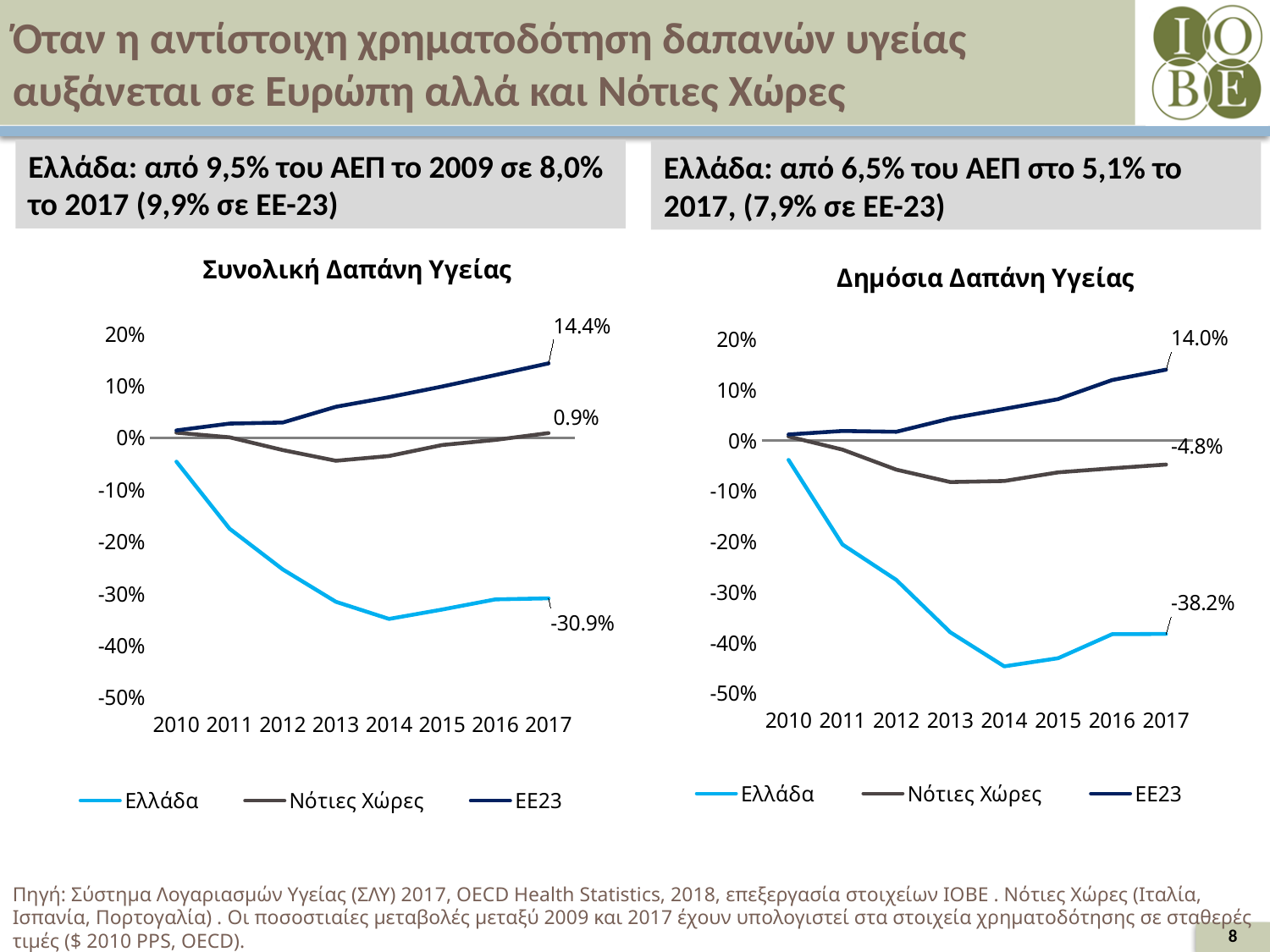
In the 'Δημόσια Δαπάνη Υγείας' chart, what is the difference between the 2017 values for ΕΕ23 and Ελλάδα? 52.2 percentage points In the 'Συνολική Δαπάνη Υγείας' chart, what is the value for ΕΕ23 in 2017? 14.4% How many series does the legend of the 'Δημόσια Δαπάνη Υγείας' chart list? 3 In the 'Δημόσια Δαπάνη Υγείας' chart, what is the value for Νότιες Χώρες in 2017? -4.8% In the 'Συνολική Δαπάνη Υγείας' chart, what is the value for Νότιες Χώρες in 2017? 0.9% What type of chart is the 'Συνολική Δαπάνη Υγείας' chart? line chart In the 'Συνολική Δαπάνη Υγείας' chart, which series has the lowest value in 2017? Ελλάδα In the 'Δημόσια Δαπάνη Υγείας' chart, is the value for Ελλάδα in 2014 greater or less than -40%? less In the 'Δημόσια Δαπάνη Υγείας' chart, what is the value for ΕΕ23 in 2017? 14.0% In the 'Δημόσια Δαπάνη Υγείας' chart, what is the value for Ελλάδα in 2017? -38.2% In the 'Συνολική Δαπάνη Υγείας' chart, what is the value for Ελλάδα in 2017? -30.9% How many years are shown on the x axis of the 'Συνολική Δαπάνη Υγείας' chart? 8